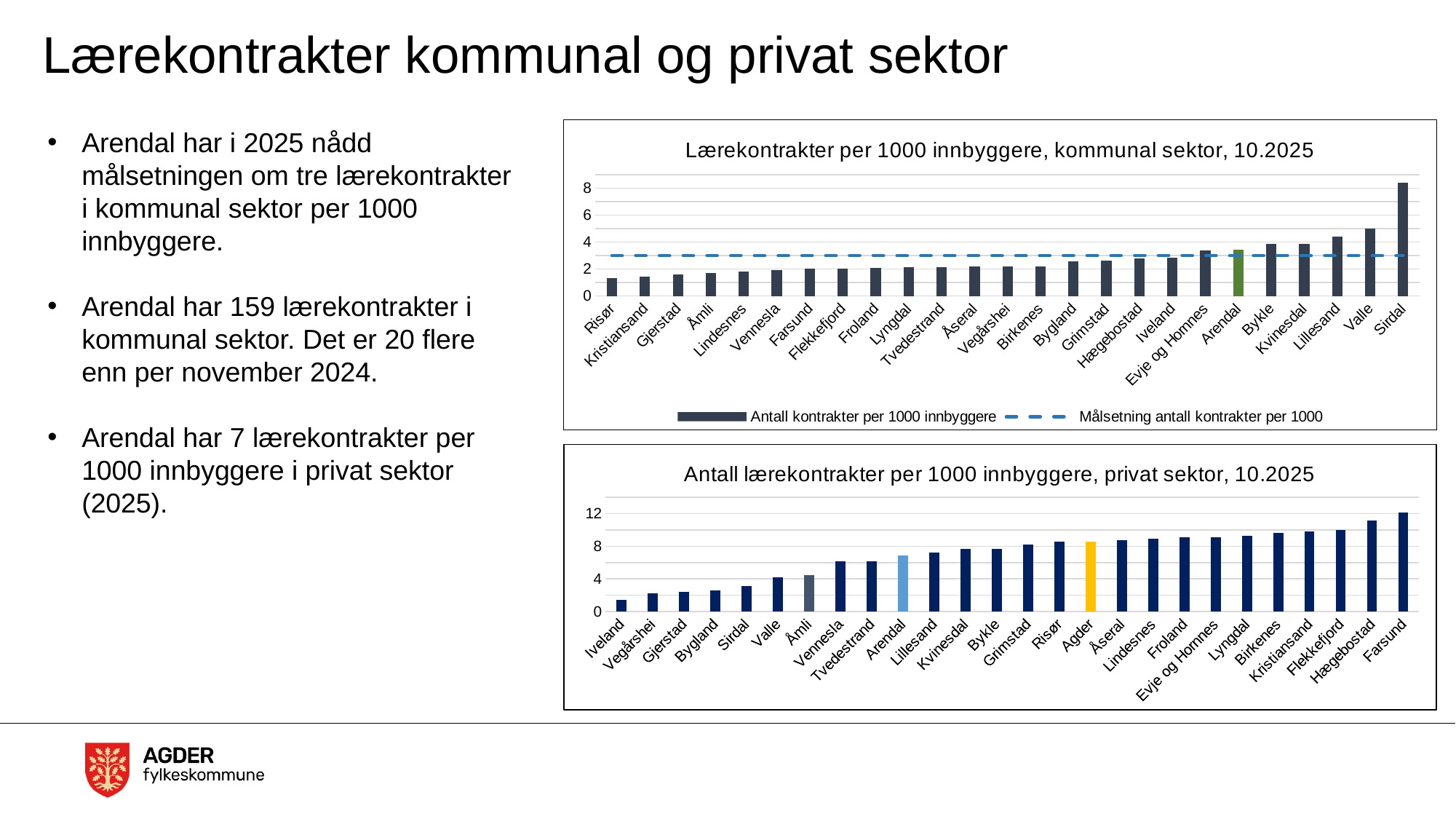
In the bottom chart (privat sektor), is the value for Arendal greater or less than 8? less In the top chart (kommunal sektor), how many series does the legend list? 2 In the top chart (kommunal sektor), is the value for Valle greater or less than 4? greater In the top chart (kommunal sektor), which municipality has the highest number of lærekontrakter per 1000 innbyggere? Sirdal What kind of chart is the bottom chart (privat sektor)? bar chart In the top chart (kommunal sektor), what does the dashed line represent according to the legend? Målsetning antall kontrakter per 1000 In the bottom chart (privat sektor), which municipality has the lowest value? Iveland In the bottom chart (privat sektor), which municipality has the highest value? Farsund In the top chart (kommunal sektor), how many municipalities are shown on the x axis? 25 In the top chart (kommunal sektor), is the value for Sirdal greater or less than 8? greater